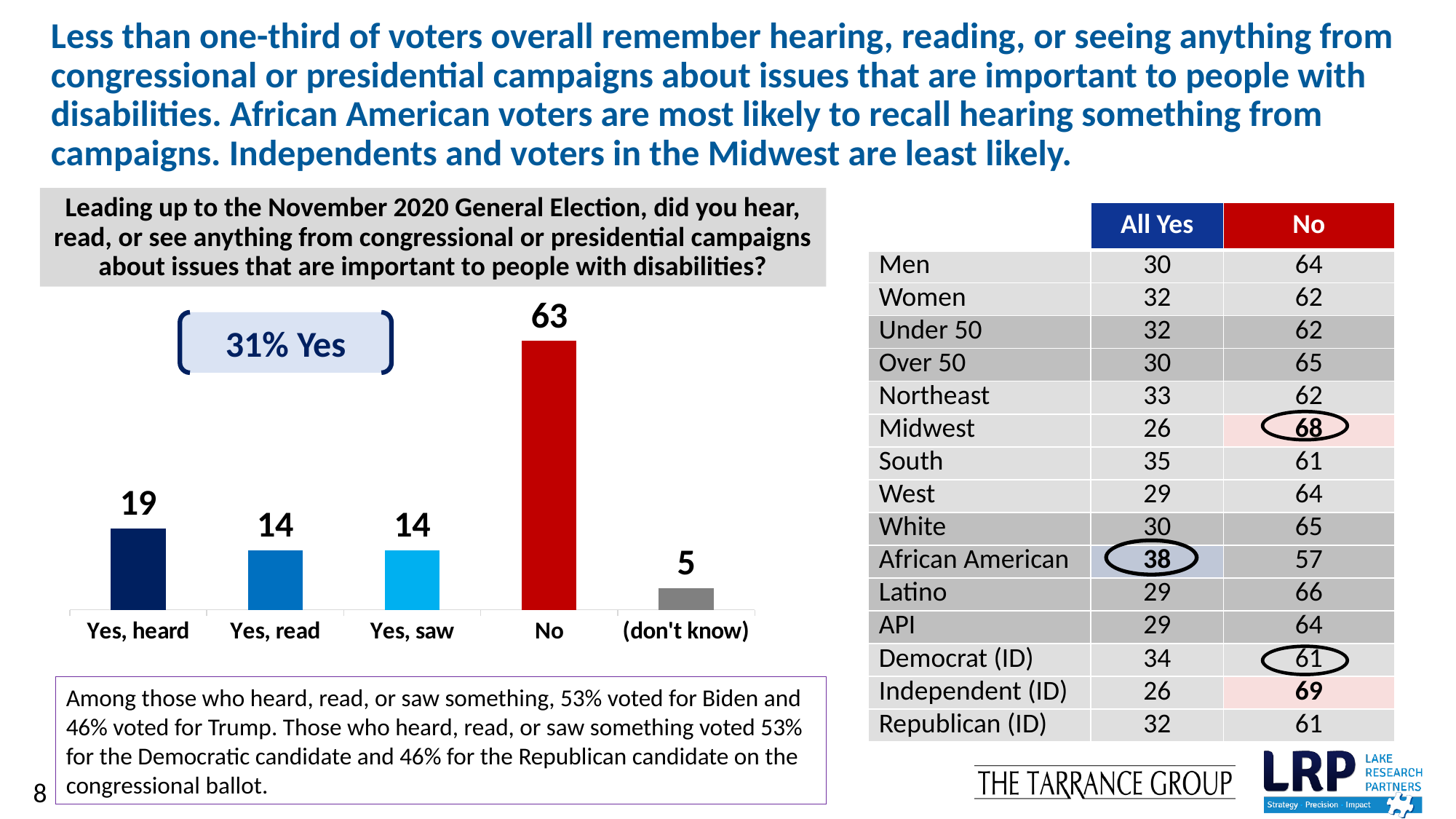
What percentage is shown in the callout box next to the bar chart? 31% Yes How many categories are shown in the bar chart? 5 What is the difference between the values for "Yes, heard" and "Yes, read" in the bar chart? 5 Which category has the highest value in the bar chart? No What kind of chart is shown on the slide? Bar chart What is the difference between the values for "No" and "Yes, heard" in the bar chart? 44 What is the value for "(don't know)" in the bar chart? 5 Which category has the lowest value in the bar chart? (don't know) What is the value for "Yes, heard" in the bar chart? 19 What is the value for "Yes, saw" in the bar chart? 14 Which is larger in the bar chart, the value for "Yes, heard" or the value for "Yes, read"? Yes, heard What is the value for "No" in the bar chart? 63